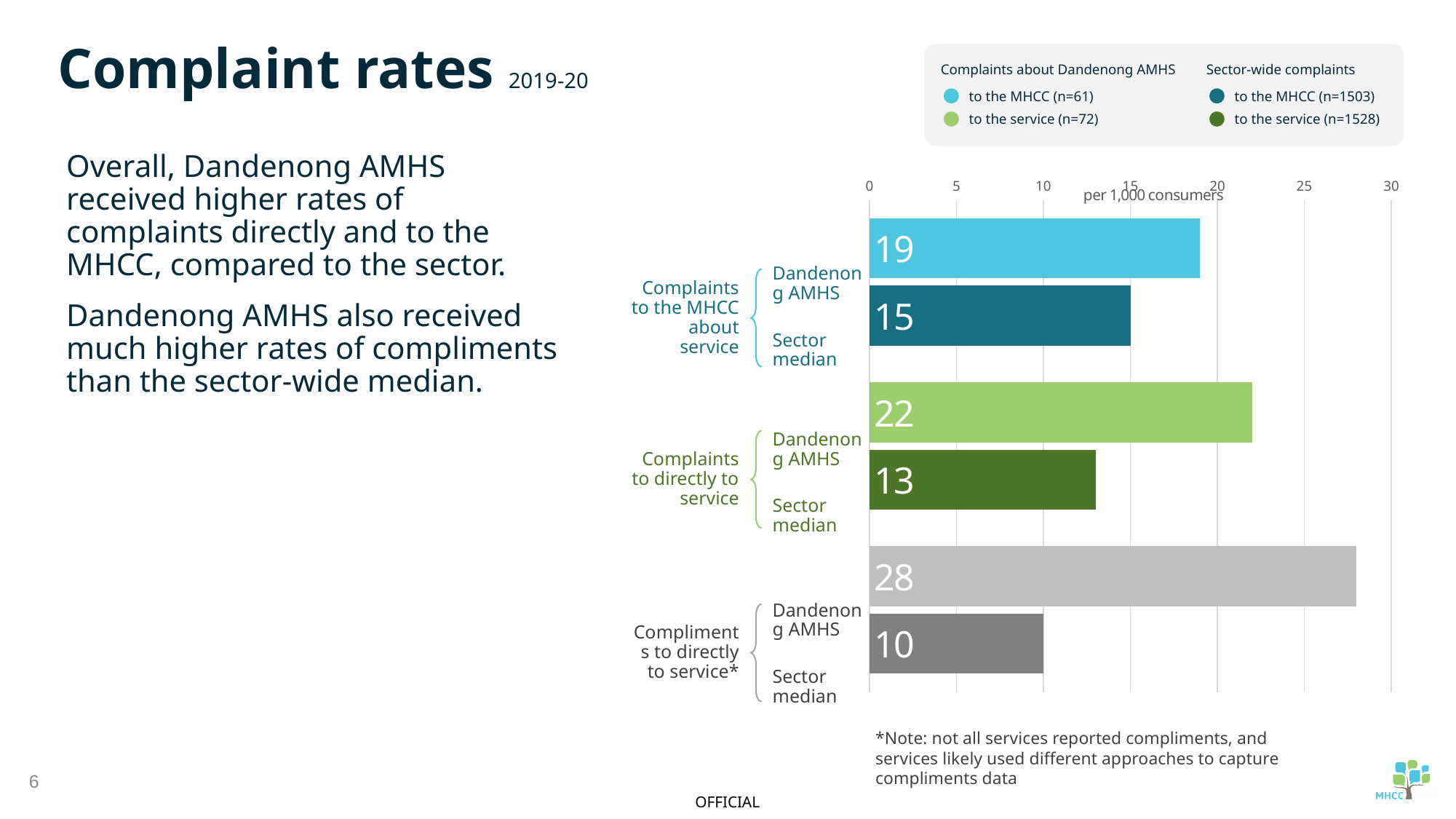
What is the difference between Dandenong AMHS and the sector median for compliments directly to service? 18 What is the sector median for complaints to the MHCC about service? 15 What is the sector median for compliments directly to service? 10 What unit does the chart's axis label say the values are measured in? per 1,000 consumers How many bars are plotted on the chart? 6 What kind of chart is shown on the slide? Bar chart What is the value for Dandenong AMHS complaints to the MHCC about service? 19 What is the difference between Dandenong AMHS and the sector median for complaints directly to service? 9 Which bar has the highest value on the chart? Dandenong AMHS compliments directly to service Which bar has the lowest value on the chart? Sector median compliments directly to service What is the value for Dandenong AMHS complaints directly to service? 22 Which is larger: Dandenong AMHS complaints to the MHCC about service or the sector median for complaints to the MHCC about service? Dandenong AMHS